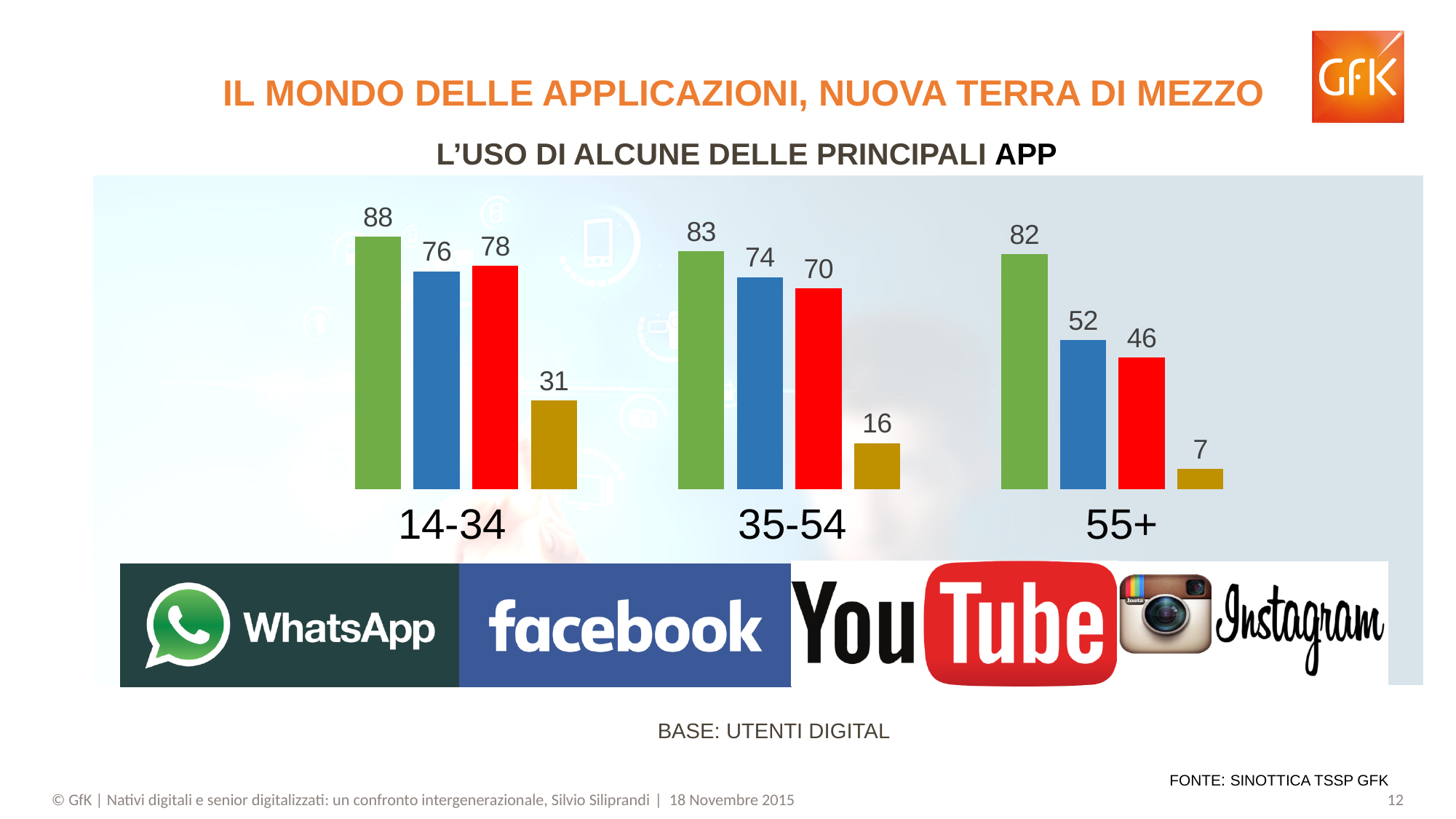
What is the value for WhatsApp in the 14-34 age group? 88 How many age groups are shown on the x axis? 3 Do the Instagram values rise or fall as the age group increases from 14-34 to 55+? Fall What is the value for Facebook in the 55+ age group? 52 What is the value for Instagram in the 55+ age group? 7 Which app has the highest value in the 55+ age group? WhatsApp What is the difference between the Facebook values for the 14-34 and 55+ age groups? 24 How many apps (series) are shown in the chart? 4 Which is larger in the 14-34 age group, the value for Facebook or the value for YouTube? YouTube What kind of chart is shown on the slide? Bar chart Which app has the lowest value in the 14-34 age group? Instagram What is the value for YouTube in the 35-54 age group? 70